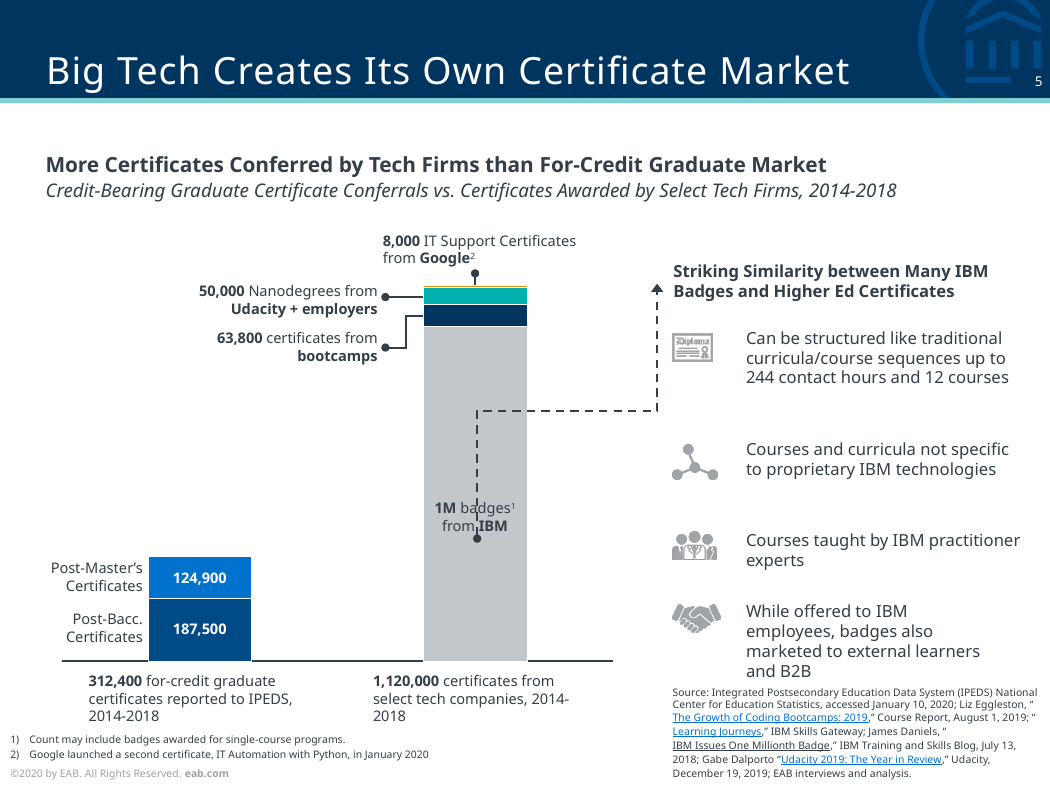
What value is shown for Post-Master's Certificates? 124,900 What kind of chart is shown on the slide? Stacked bar chart What is the total of the certificates from select tech companies bar? 1,120,000 What is the chart's subtitle? Credit-Bearing Graduate Certificate Conferrals vs. Certificates Awarded by Select Tech Firms, 2014-2018 What value is shown for Post-Bacc. Certificates? 187,500 How many certificates from bootcamps are shown? 63,800 How many Nanodegrees from Udacity + employers are shown? 50,000 Which is larger, Post-Bacc. Certificates or Post-Master's Certificates? Post-Bacc. Certificates What is the total of the for-credit graduate certificates bar? 312,400 What is the difference between Post-Bacc. Certificates and Post-Master's Certificates? 62,600 Which segment of the tech companies bar is the largest? 1M badges from IBM How many IT Support Certificates from Google are shown? 8,000